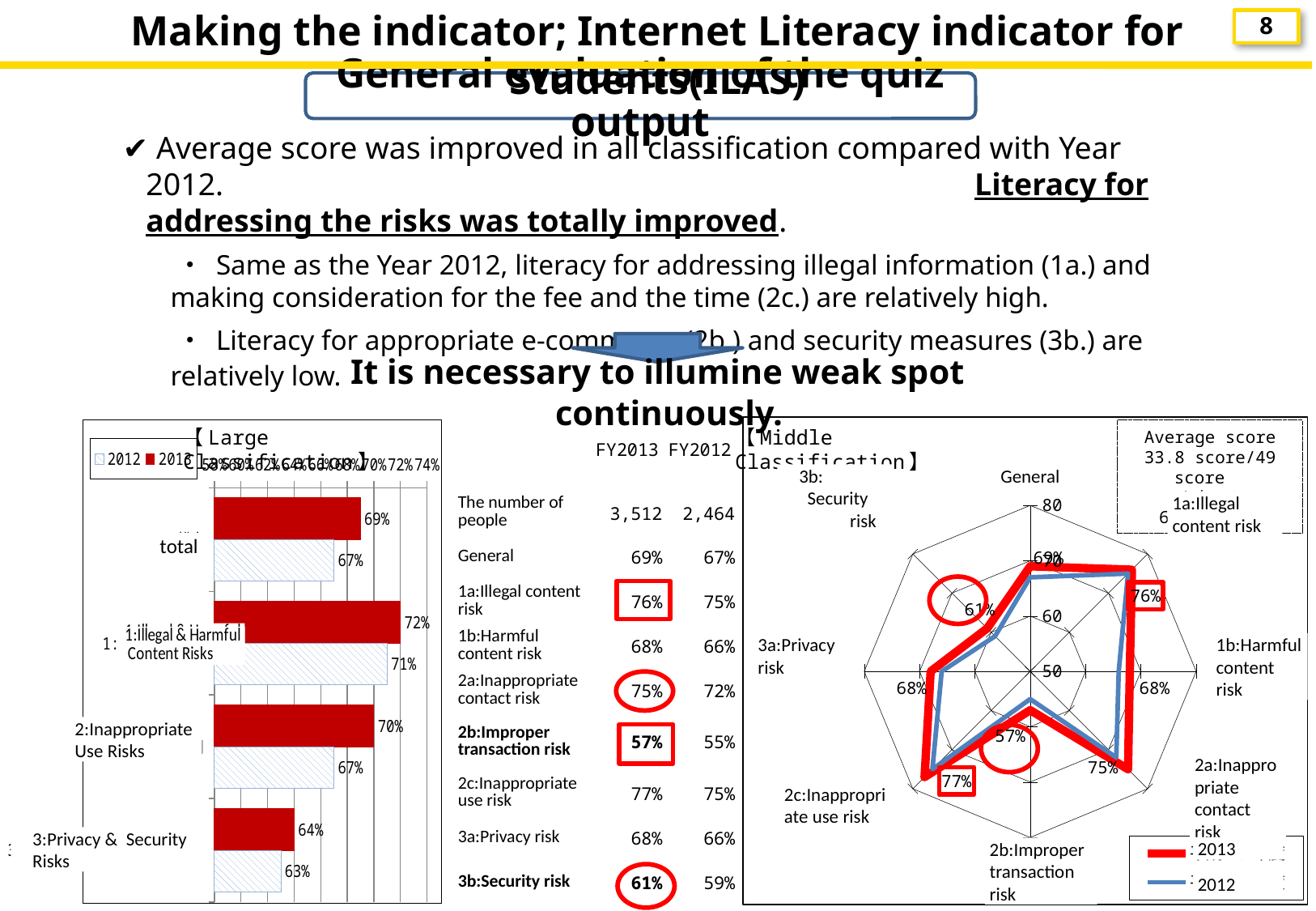
In the bar chart on the left, what is the 2012 value for 3:Privacy & Security Risks? 63% What kind of chart is the chart on the left of the slide? bar chart In the bar chart on the left, which category has the highest 2013 value? 1:Illegal & Harmful Content Risks In the radar chart on the right, which category has the lowest 2013 value? 2b:Improper transaction risk In the bar chart on the left, what is the difference between the 2013 and 2012 values for 2:Inappropriate Use Risks? 3% In the bar chart on the left, which category has the lowest 2013 value? 3:Privacy & Security Risks In the radar chart on the right, what is the 2013 value for 2c:Inappropriate use risk? 77% In the bar chart on the left, how many series does the legend list? 2 In the radar chart on the right, what is the 2013 value for 2b:Improper transaction risk? 57% In the radar chart on the right, how many categories (axes) are plotted? 8 In the bar chart on the left, what is the 2013 value for total? 69% In the radar chart on the right, is the 2013 value for 1a:Illegal content risk larger or smaller than the 2013 value for 3b:Security risk? larger